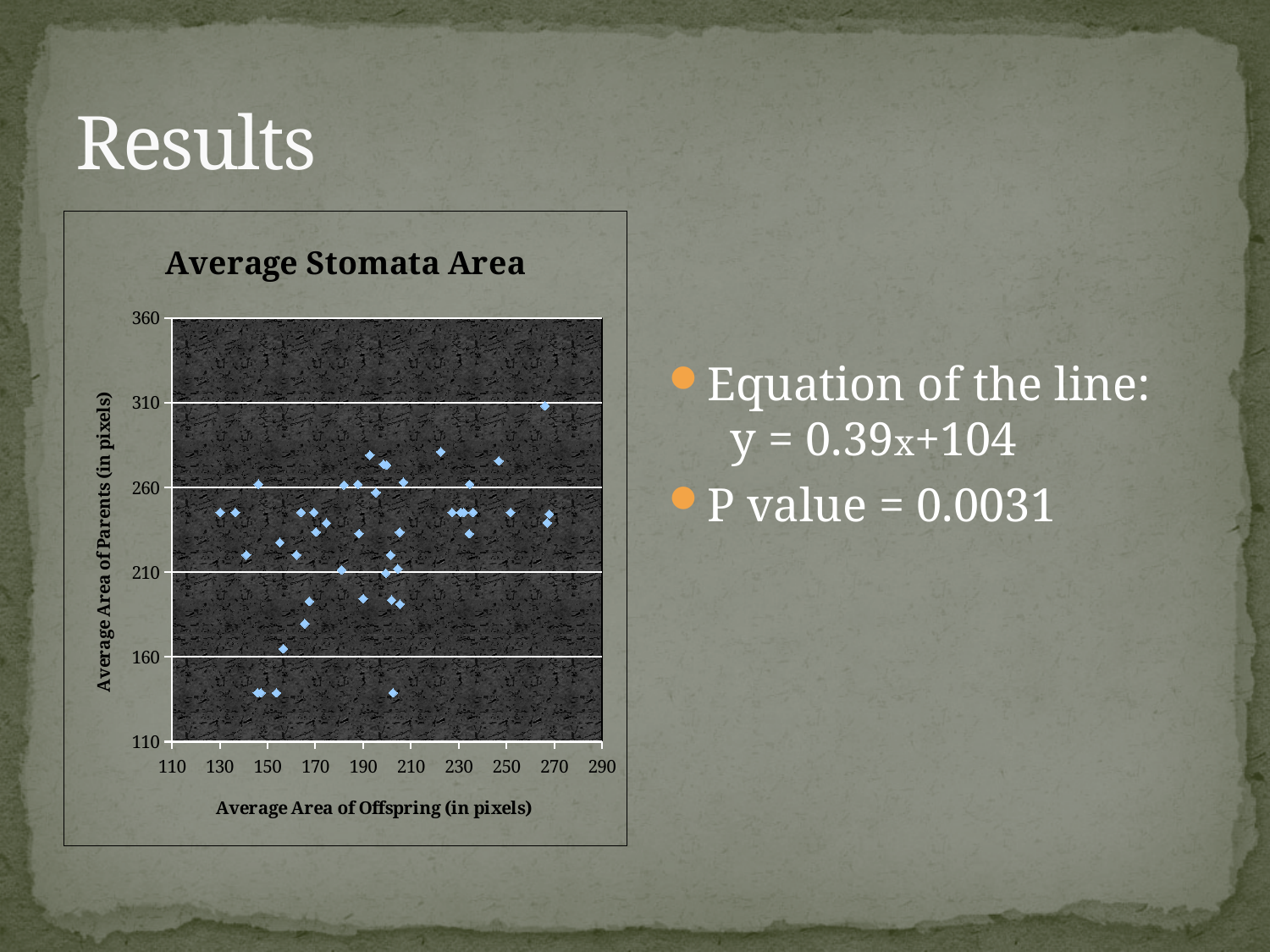
According to the fitted line equation on the slide, do the y values generally rise or fall as x increases? rise Is the x value of the leftmost point on the chart greater or less than 150? less Is the y value of the lowest points on the chart greater or less than 160? less Is the y value of the highest point on the chart greater or less than 360? less What is the title of the chart? Average Stomata Area What is the label of the x axis of the chart? Average Area of Offspring (in pixels) What kind of chart is shown on the slide? scatter chart